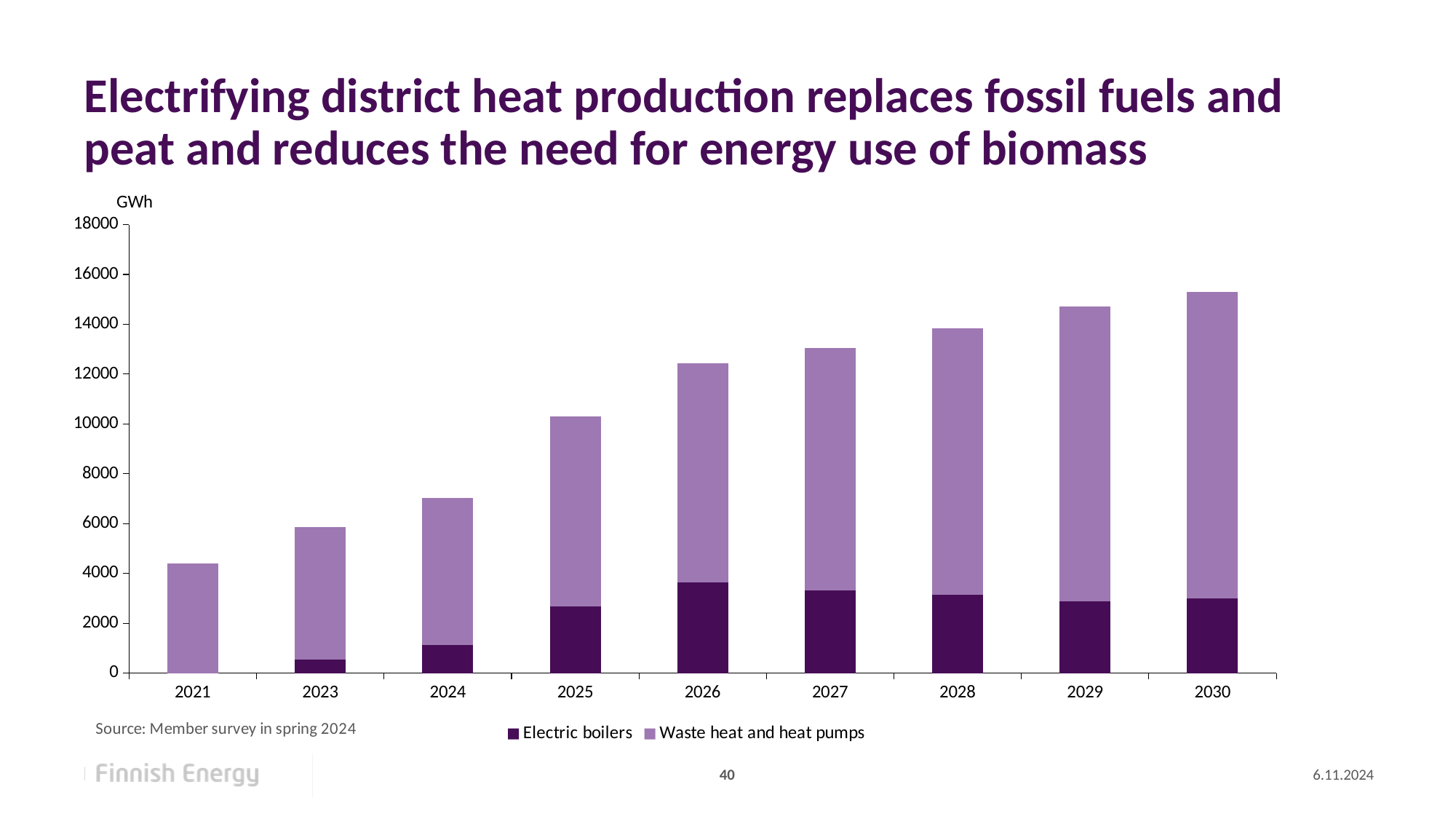
Is the total value for 2030 greater or less than 14000? greater Which year has the largest Electric boilers segment? 2026 How many series does the legend list? 2 Is the total value for 2024 greater or less than 8000? less Which year has the highest total bar? 2030 Is the Electric boilers value for 2026 greater or less than 4000? less Which year has the lowest total bar? 2021 How many years are shown on the x axis? 9 Do the total bar heights rise or fall from 2021 to 2030? rise What unit is shown on the y axis? GWh What kind of chart is shown on the slide? bar chart